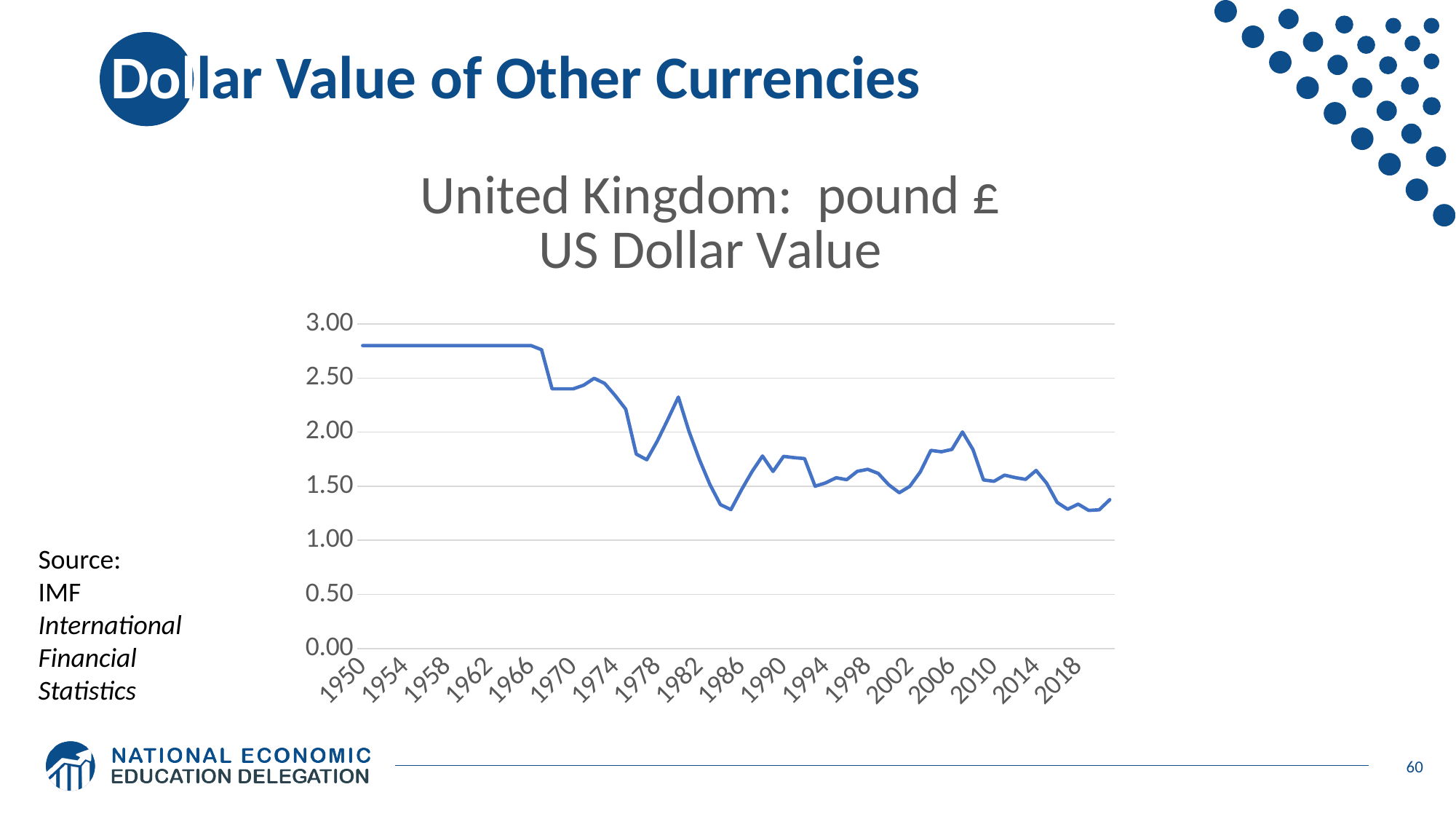
Is the value for 1982 greater or less than 2.00? less Which year has the larger value, 1950 or 2018? 1950 How many year labels are shown on the x axis? 18 Overall, does the US dollar value of the pound rise or fall from 1950 to 2018? fall Is the value for 1978 greater or less than 1.50? greater What is the title of the chart? United Kingdom: pound £ US Dollar Value Is the value for 2018 greater or less than 1.50? less What kind of chart is shown on the slide? line chart What is the highest value shown on the y axis? 3.00